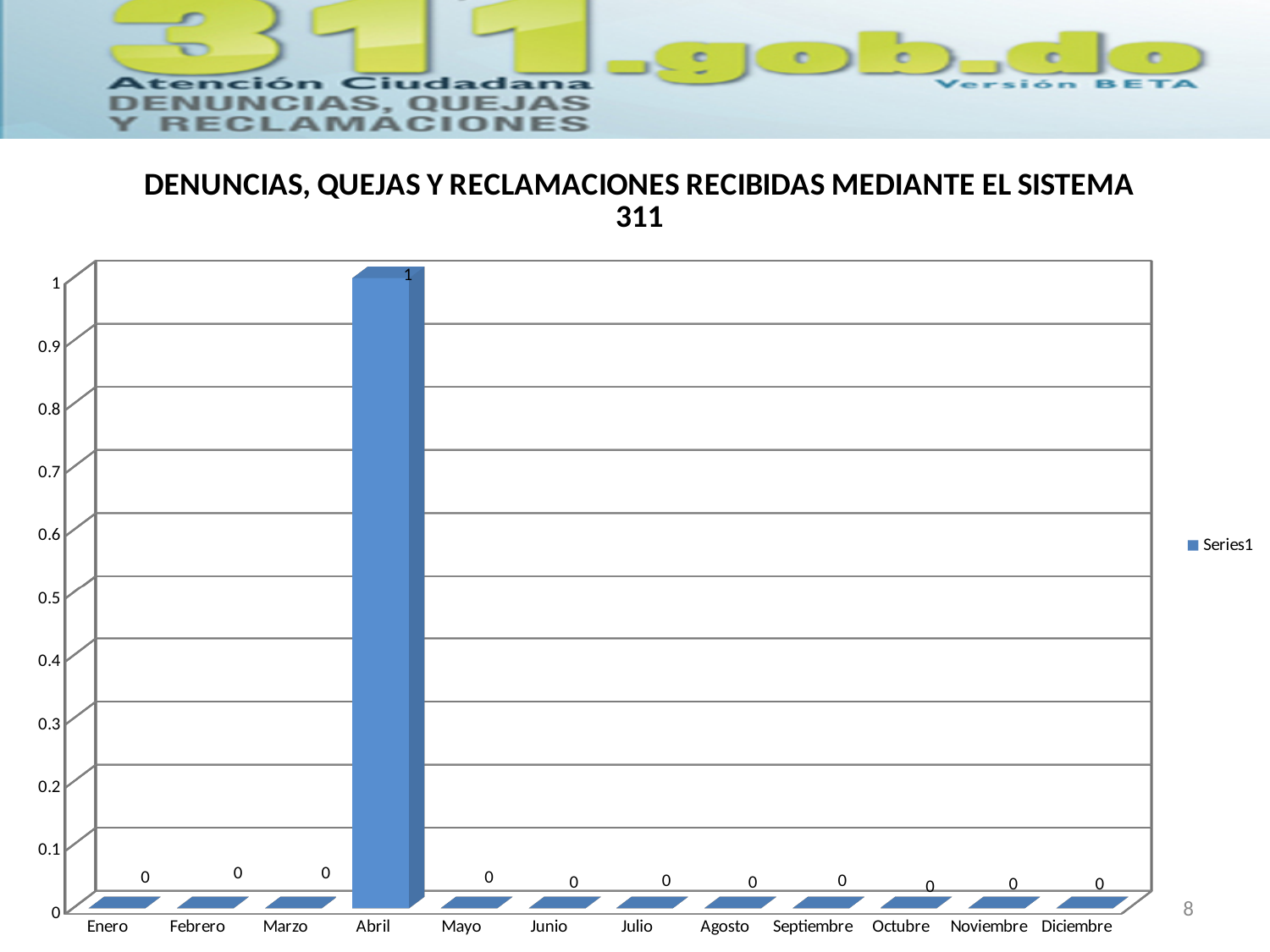
Is the value for Abril greater or less than 0.5? greater How many series does the legend list? 1 What is the difference between the values for Abril and Mayo? 1 What is the title of the chart? DENUNCIAS, QUEJAS Y RECLAMACIONES RECIBIDAS MEDIANTE EL SISTEMA 311 What is the name of the series shown in the legend? Series1 How many months are shown on the x axis? 12 What is the value for Enero? 0 Which month has the highest value? Abril What kind of chart is shown on the slide? bar chart What is the value for Septiembre? 0 Which is larger, the value for Abril or the value for Diciembre? Abril What is the value for Abril? 1